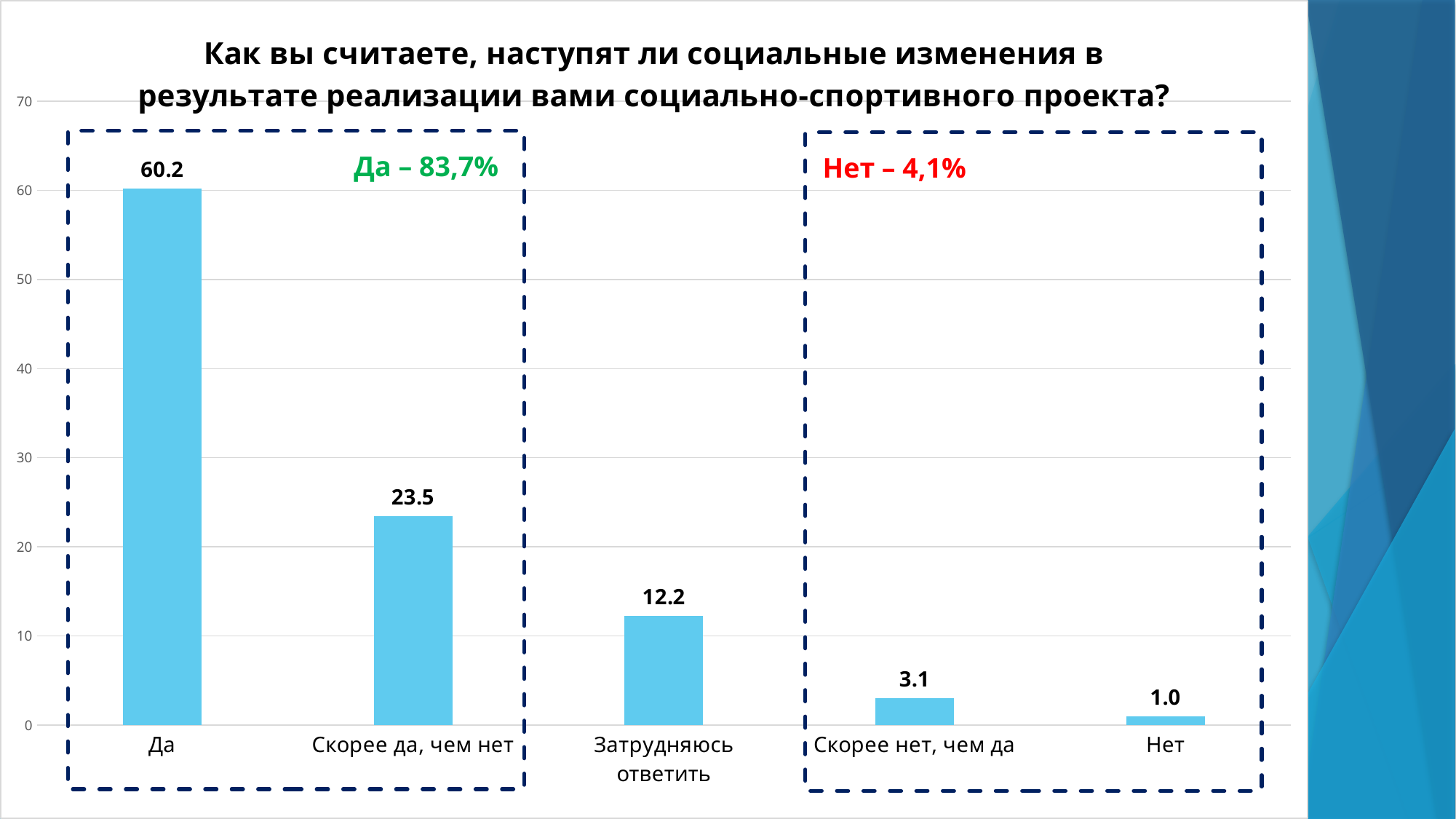
Which is larger, the value for "Скорее нет, чем да" or the value for "Нет"? Скорее нет, чем да Do the values rise or fall from left to right along the x axis? Fall What is the difference between the values for "Да" and "Скорее да, чем нет"? 36.7 Which category has the lowest value? Нет What kind of chart is shown on the slide? Bar chart How many categories are shown on the x axis? 5 What is the value for the category "Да"? 60.2 What is the value for the category "Нет"? 1.0 Which category has the highest value? Да What is the value for the category "Скорее да, чем нет"? 23.5 What is the value for the category "Затрудняюсь ответить"? 12.2 What combined percentage is shown in the green text for the "Да" group? 83,7%